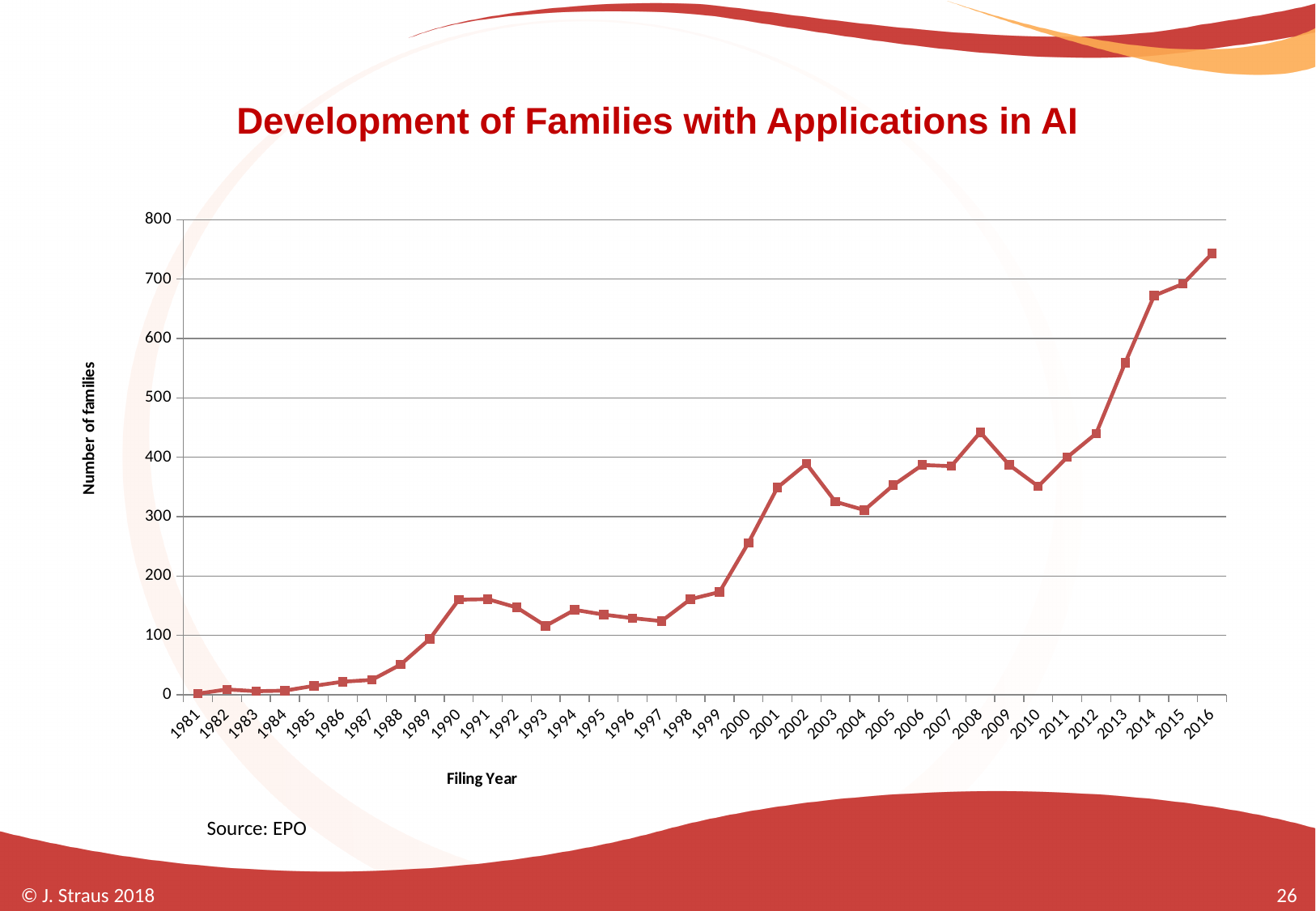
Overall, do the values rise or fall from 1981 to 2016? Rise Which filing year has the highest number of families? 2016 Is the value for 2002 greater or less than 300? greater Is the value for 1988 greater or less than 100? less How many filing years are plotted on the x axis? 36 Which year has the larger number of families, 1991 or 1993? 1991 Is the value for 2016 greater or less than 700? greater What is the label of the y axis? Number of families Which year has the larger number of families, 2008 or 2010? 2008 What kind of chart is shown on the slide? Line chart